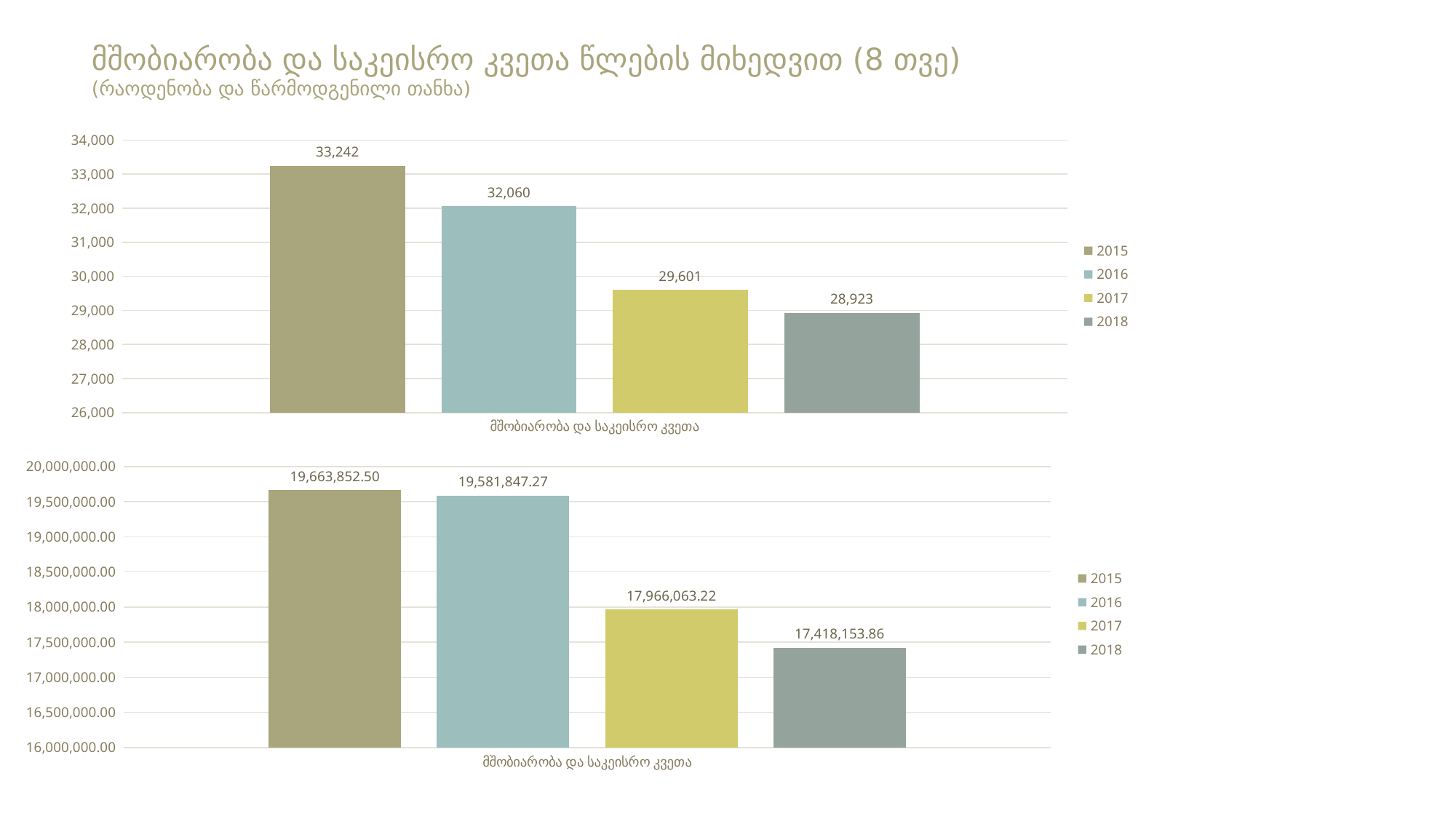
In the top chart, what is the value for 2015? 33,242 In the bottom chart, what is the value for 2016? 19,581,847.27 What kind of chart is the bottom chart? Bar chart In the top chart, what is the value for 2017? 29,601 In the top chart, is the value for 2016 larger than the value for 2017? Yes In the bottom chart, which year has the highest value? 2015 In the top chart, what is the difference between the values for 2015 and 2016? 1,182 In the bottom chart, what is the difference between the values for 2017 and 2018? 547,909.36 How many series does the legend of the top chart list? 4 In the top chart, which year has the lowest value? 2018 In the bottom chart, is the value for 2017 greater or less than 18,000,000.00? less In the bottom chart, what is the value for 2018? 17,418,153.86